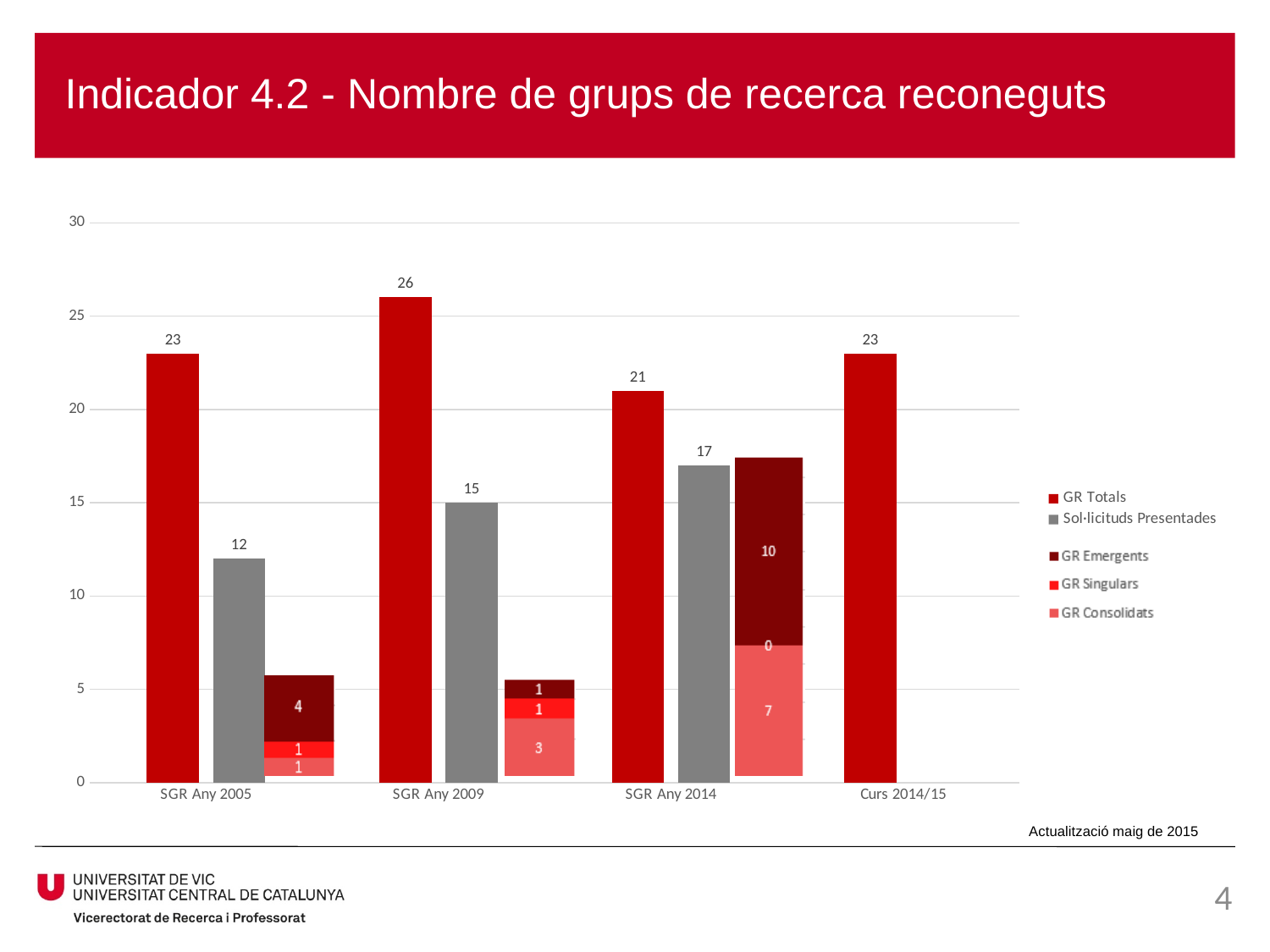
Which category has the highest GR Totals value? SGR Any 2009 What is the value of GR Consolidats for SGR Any 2009? 3 What is the value of GR Totals for SGR Any 2009? 26 Which category has the lowest Sol·licituds Presentades value? SGR Any 2005 What is the total of the stacked bar (GR Emergents, GR Singulars and GR Consolidats) for SGR Any 2005? 6 How many series does the legend list? 5 How many categories are shown on the x axis? 4 Which is larger for SGR Any 2014: GR Emergents or GR Consolidats? GR Emergents What is the value of GR Emergents for SGR Any 2014? 10 What is the difference between GR Totals and Sol·licituds Presentades for SGR Any 2005? 11 What is the value of Sol·licituds Presentades for SGR Any 2014? 17 What kind of chart is shown on the slide? Bar chart